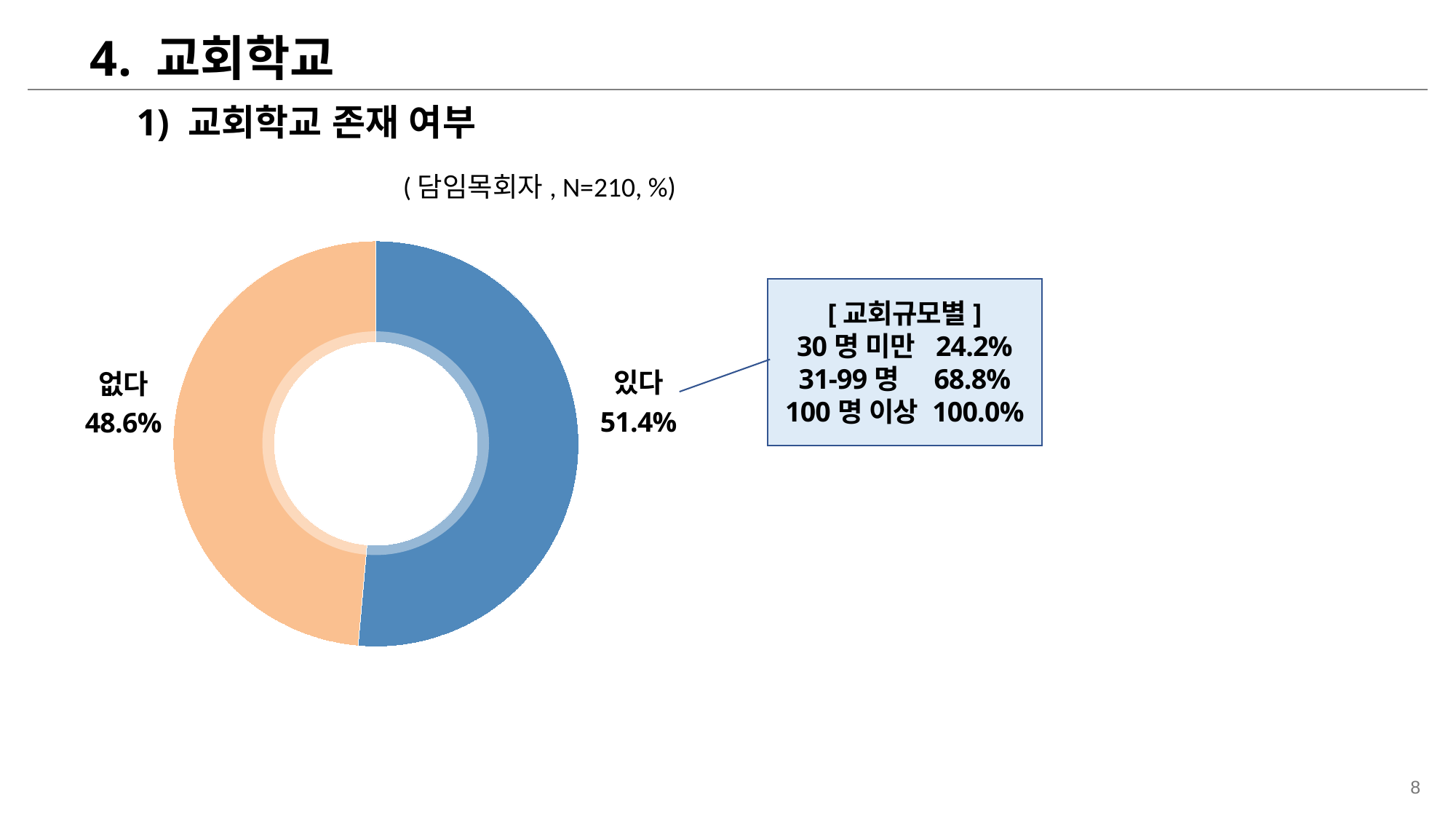
What kind of chart is shown on the slide? Doughnut (pie) chart Which category has the smallest share? 없다 What is the sample size (N) stated above the chart? 210 What is the difference between the shares of 있다 and 없다? 2.8% In the 교회규모별 box, what is the value for 31-99 명? 68.8% In the 교회규모별 box, which church size group has the highest value? 100 명 이상 What is the value for 없다? 48.6% How many categories are shown in the chart? 2 Which category has the larger share, 있다 or 없다? 있다 What is the value for 있다? 51.4% In the 교회규모별 box, what is the value for 30 명 미만? 24.2% What colour is the 있다 slice? Blue